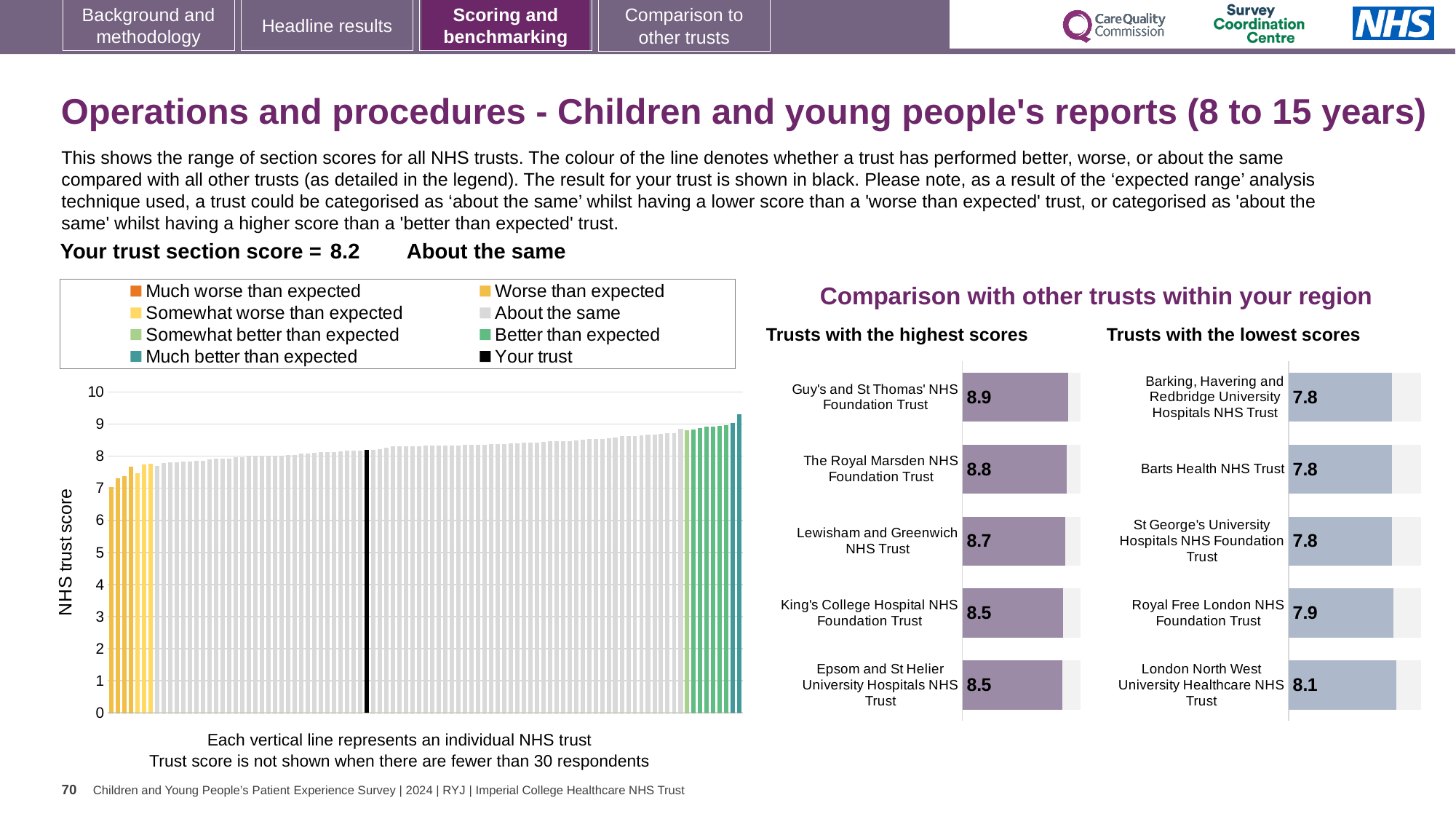
In the large chart on the left, is the value of the lowest bar greater or less than 8? less In the 'Trusts with the highest scores' chart, which trust has the highest score? Guy's and St Thomas' NHS Foundation Trust How many trusts are shown in the 'Trusts with the lowest scores' chart? 5 In the large chart on the left, do the bar values rise or fall from left to right along the x axis? rise In the 'Trusts with the highest scores' chart, what is the difference between the scores of Guy's and St Thomas' NHS Foundation Trust and Lewisham and Greenwich NHS Trust? 0.2 In the large chart on the left, is the value of the tallest bar greater or less than 8? greater What kind of chart is the large chart on the left showing the range of section scores for all NHS trusts? bar chart In the 'Trusts with the lowest scores' chart, which has the larger score: Royal Free London NHS Foundation Trust or Barts Health NHS Trust? Royal Free London NHS Foundation Trust In the 'Trusts with the highest scores' chart, what is the score for Guy's and St Thomas' NHS Foundation Trust? 8.9 How many entries does the legend above the large chart on the left list? 8 In the 'Trusts with the lowest scores' chart, what is the score for London North West University Healthcare NHS Trust? 8.1 In the large chart on the left, what is the label on the vertical axis? NHS trust score